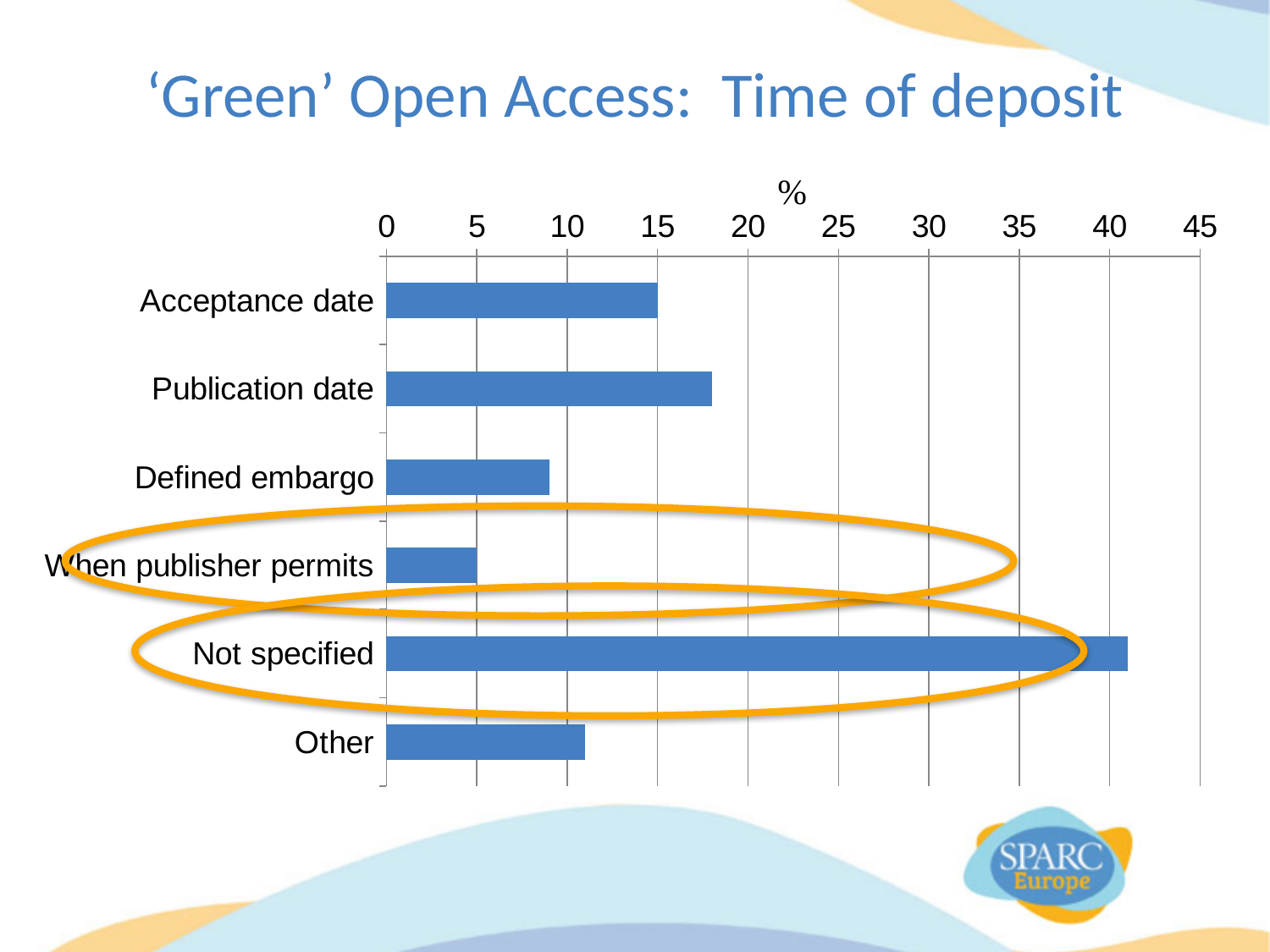
What unit label is shown on the value axis of the chart? % Which category has the highest value? Not specified Is the value for Defined embargo greater or less than 10? less How many categories are plotted in the chart? 6 Which is larger, the value for Publication date or the value for Acceptance date? Publication date Is the value for Not specified greater or less than 40? greater Which is larger, the value for Other or the value for Defined embargo? Other Which two categories are circled in orange on the chart? When publisher permits and Not specified Is the value for Other greater or less than 10? greater What kind of chart is shown on the slide? bar chart Which category has the lowest value? When publisher permits